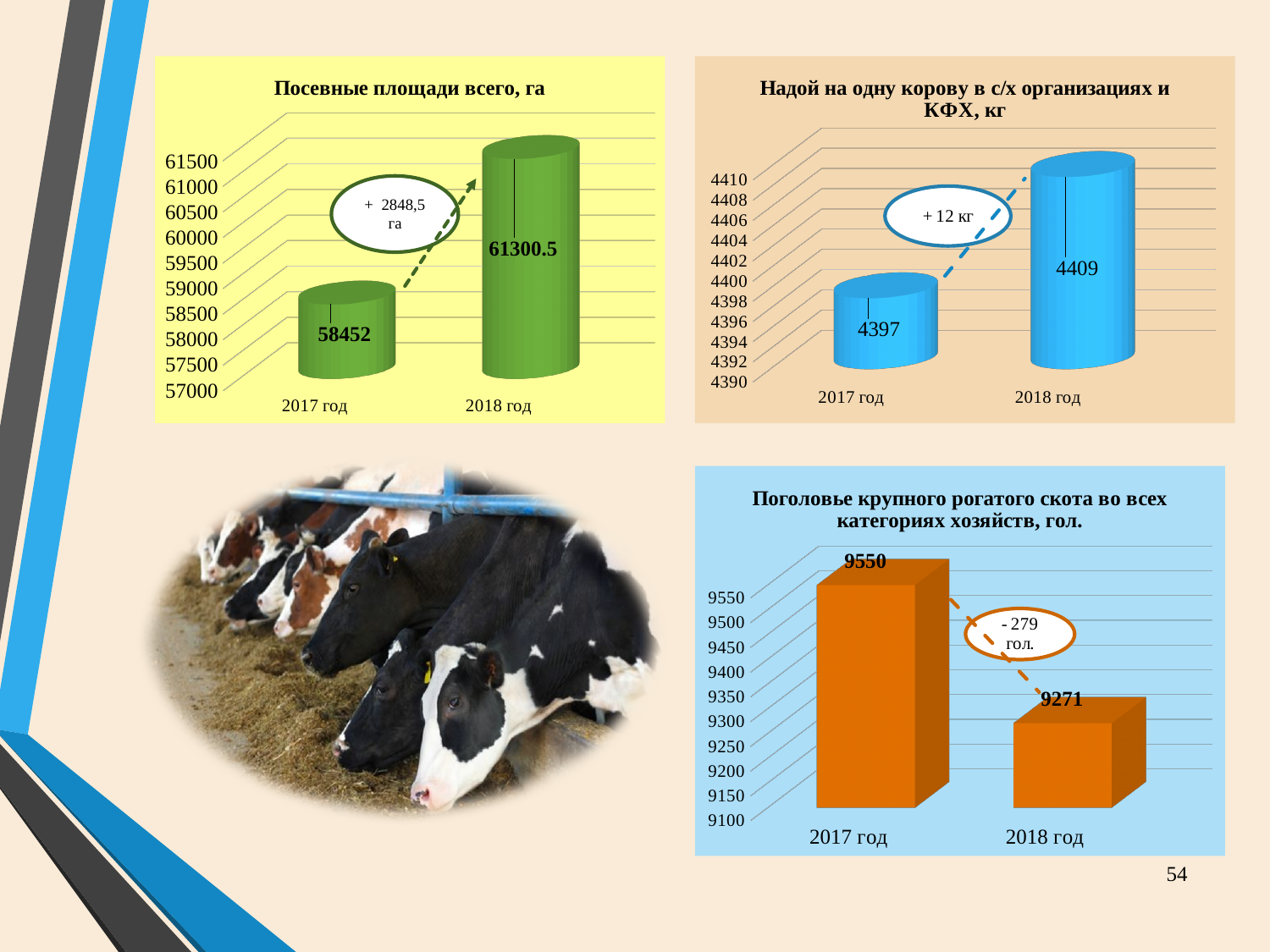
In the chart titled "Надой на одну корову в с/х организациях и КФХ, кг", what is the difference between the 2018 год and 2017 год values? 12 What kind of chart is the one titled "Надой на одну корову в с/х организациях и КФХ, кг"? bar chart In the chart titled "Поголовье крупного рогатого скота во всех категориях хозяйств, гол.", which year has the lower value? 2018 год In the chart titled "Надой на одну корову в с/х организациях и КФХ, кг", what is the value for 2018 год? 4409 In the chart titled "Поголовье крупного рогатого скота во всех категориях хозяйств, гол.", what is the value for 2018 год? 9271 In the chart titled "Поголовье крупного рогатого скота во всех категориях хозяйств, гол.", what is the value for 2017 год? 9550 In the chart titled "Посевные площади всего, га", what is the value for 2017 год? 58452 In the chart titled "Поголовье крупного рогатого скота во всех категориях хозяйств, гол.", do the values rise or fall from 2017 год to 2018 год? fall In the chart titled "Посевные площади всего, га", how many categories are shown on the x axis? 2 In the chart titled "Посевные площади всего, га", what is the value for 2018 год? 61300.5 In the chart titled "Посевные площади всего, га", by how much does the 2018 год value exceed the 2017 год value? 2848.5 In the chart titled "Надой на одну корову в с/х организациях и КФХ, кг", what is the value for 2017 год? 4397